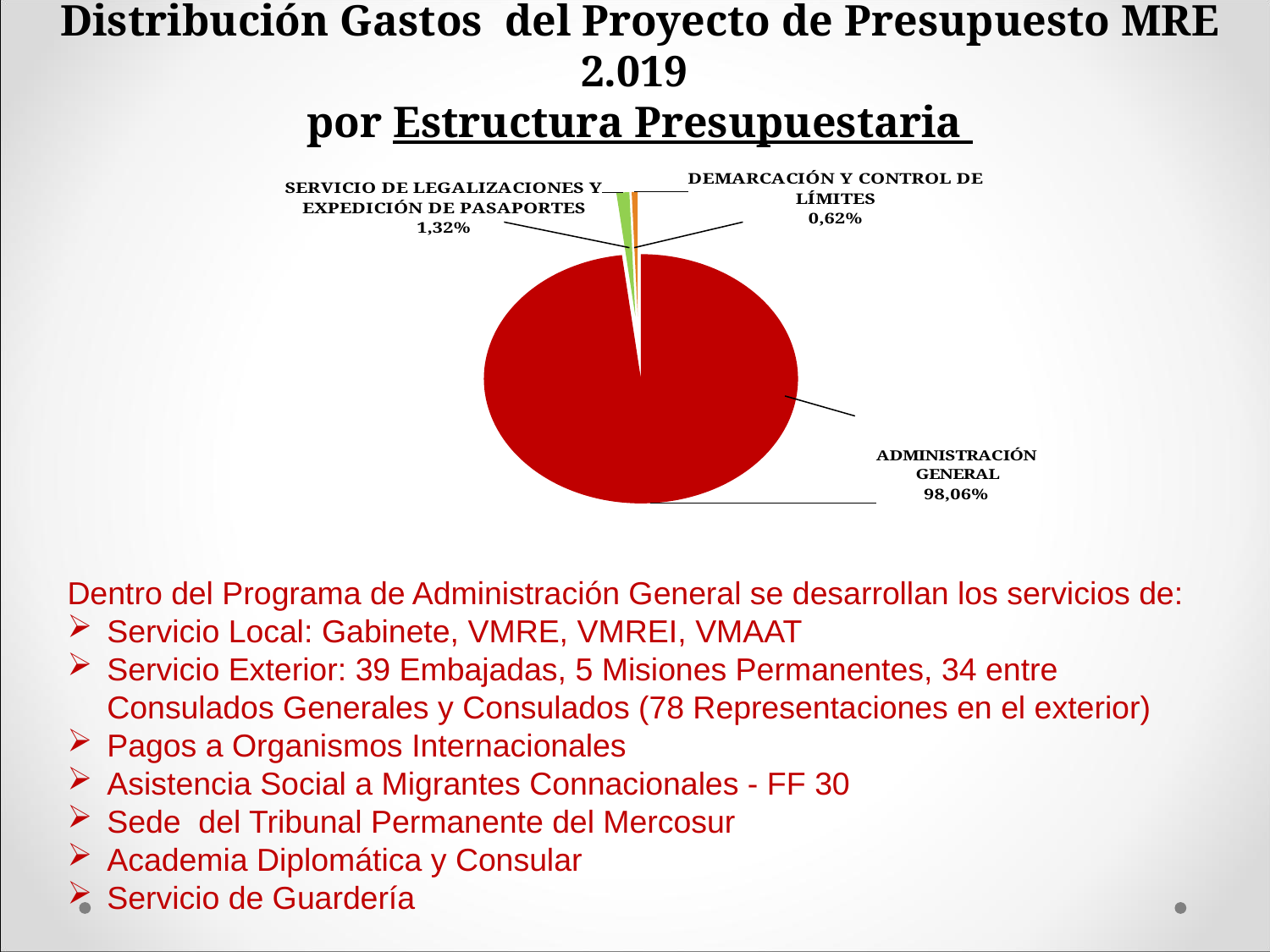
What is the title of the slide containing the pie chart? Distribución Gastos del Proyecto de Presupuesto MRE 2.019 por Estructura Presupuestaria What share of the pie does DEMARCACIÓN Y CONTROL DE LÍMITES represent? 0,62% What is the difference between the shares of SERVICIO DE LEGALIZACIONES Y EXPEDICIÓN DE PASAPORTES and DEMARCACIÓN Y CONTROL DE LÍMITES? 0,70% What share of the pie does SERVICIO DE LEGALIZACIONES Y EXPEDICIÓN DE PASAPORTES represent? 1,32% What share of the pie does ADMINISTRACIÓN GENERAL represent? 98,06% How many categories are shown in the pie chart? 3 What is the difference between the shares of ADMINISTRACIÓN GENERAL and SERVICIO DE LEGALIZACIONES Y EXPEDICIÓN DE PASAPORTES? 96,74% Which is larger, the share of SERVICIO DE LEGALIZACIONES Y EXPEDICIÓN DE PASAPORTES or the share of DEMARCACIÓN Y CONTROL DE LÍMITES? SERVICIO DE LEGALIZACIONES Y EXPEDICIÓN DE PASAPORTES What colour is the ADMINISTRACIÓN GENERAL slice of the pie? Red Which category has the smallest slice of the pie? DEMARCACIÓN Y CONTROL DE LÍMITES Which category has the largest slice of the pie? ADMINISTRACIÓN GENERAL What kind of chart is shown on the slide? Pie chart